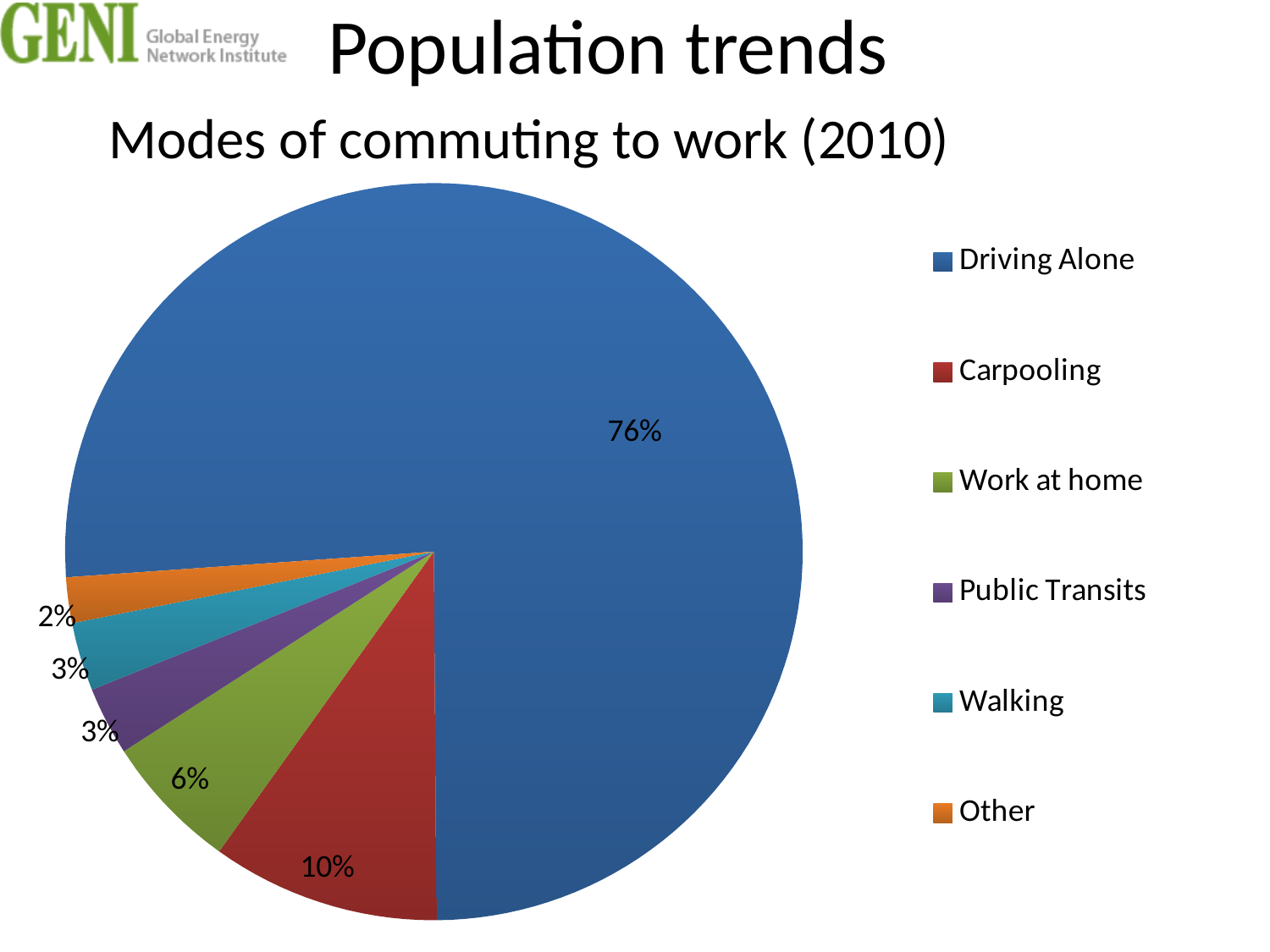
What is the value shown for Other? 2% What kind of chart is shown on the slide? pie chart What is the value shown for Work at home? 6% Which mode of commuting has the largest slice? Driving Alone How many categories does the pie chart show? 6 What is the title of the chart? Modes of commuting to work (2010) Which is larger, the share for Carpooling or the share for Work at home? Carpooling Which colour represents Walking in the legend? teal Which mode of commuting has the smallest slice? Other What share of the pie does Driving Alone take? 76% What is the value shown for Carpooling? 10% What is the difference between the Driving Alone share and the Carpooling share? 66%